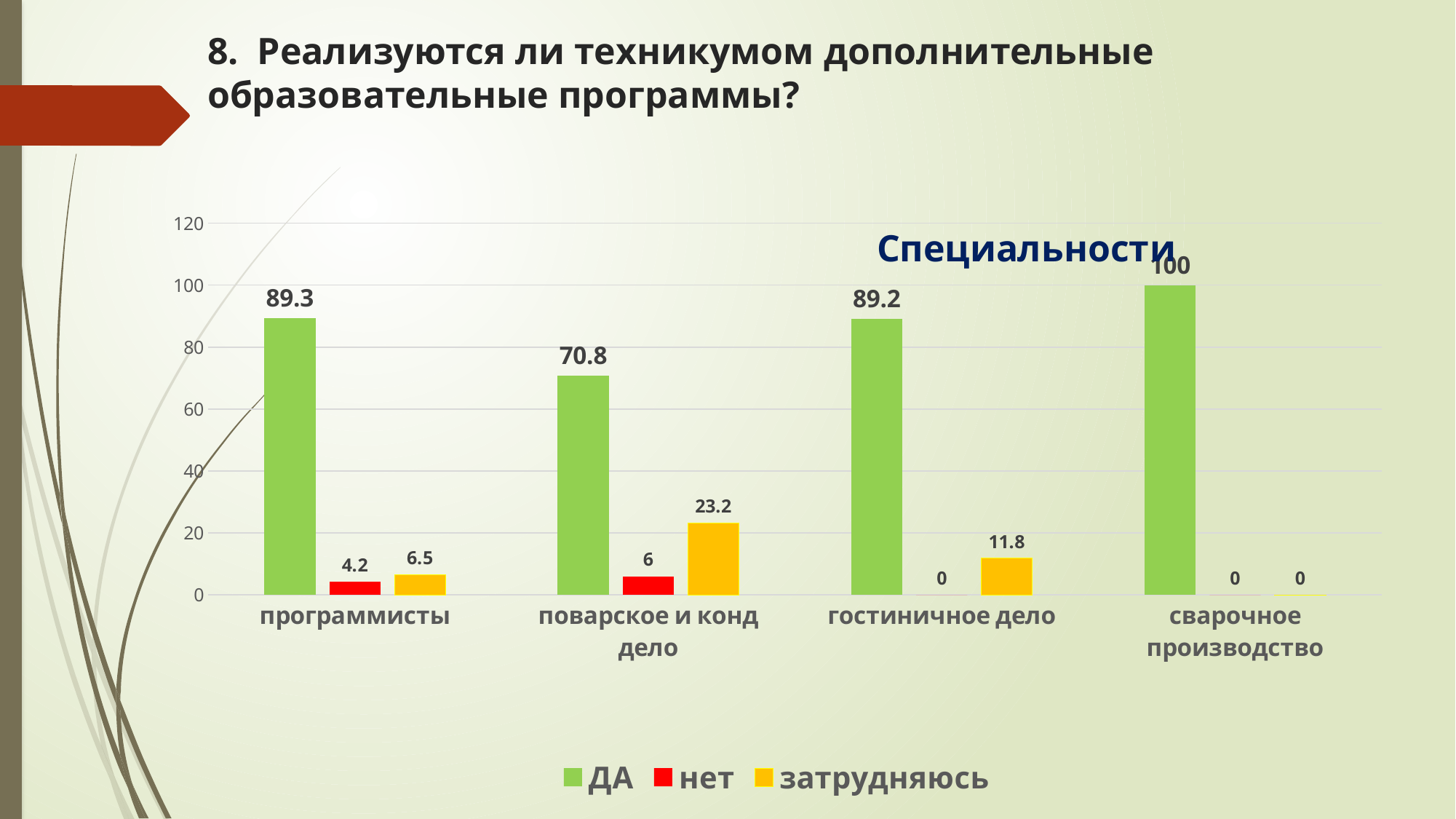
Is the ДА value for поварское и конд дело greater or less than 80? less How many categories are shown on the x axis? 4 Which category has the highest value in the ДА series? сварочное производство What is the title of the chart? Специальности What is the difference between the ДА values for сварочное производство and поварское и конд дело? 29.2 What is the value of the ДА series for программисты? 89.3 How many series does the legend list? 3 Which category has the lowest value in the ДА series? поварское и конд дело What is the value of the нет series for гостиничное дело? 0 What kind of chart is shown on the slide? bar chart What is the value of the затрудняюсь series for поварское и конд дело? 23.2 Which is larger: the затрудняюсь value for программисты or for гостиничное дело? гостиничное дело